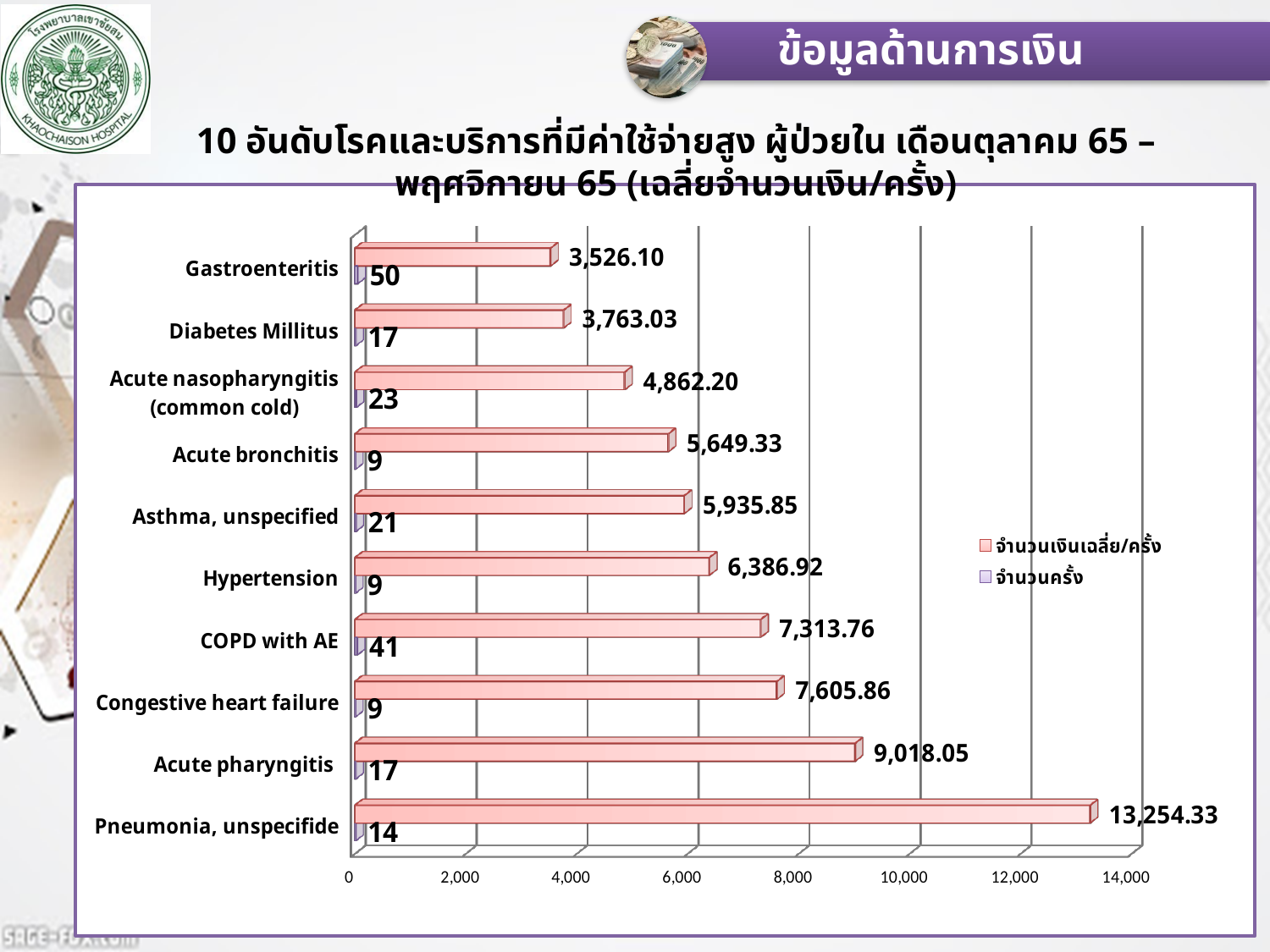
What is the average cost per visit for COPD with AE? 7,313.76 Which disease has the lowest average cost per visit? Gastroenteritis Which has a higher average cost per visit, Hypertension or Asthma, unspecified? Hypertension What is the number of visits for COPD with AE? 41 Which disease has the highest average cost per visit? Pneumonia, unspecifide What is the average cost per visit (จำนวนเงินเฉลี่ย/ครั้ง) for Pneumonia, unspecifide? 13,254.33 Which disease has the highest number of visits (จำนวนครั้ง)? Gastroenteritis What is the number of visits (จำนวนครั้ง) for Gastroenteritis? 50 What is the difference in average cost per visit between Acute pharyngitis and Congestive heart failure? 1,412.19 How many diseases/services are shown in the chart? 10 How many series does the legend list? 2 What type of chart is shown on the slide? Bar chart